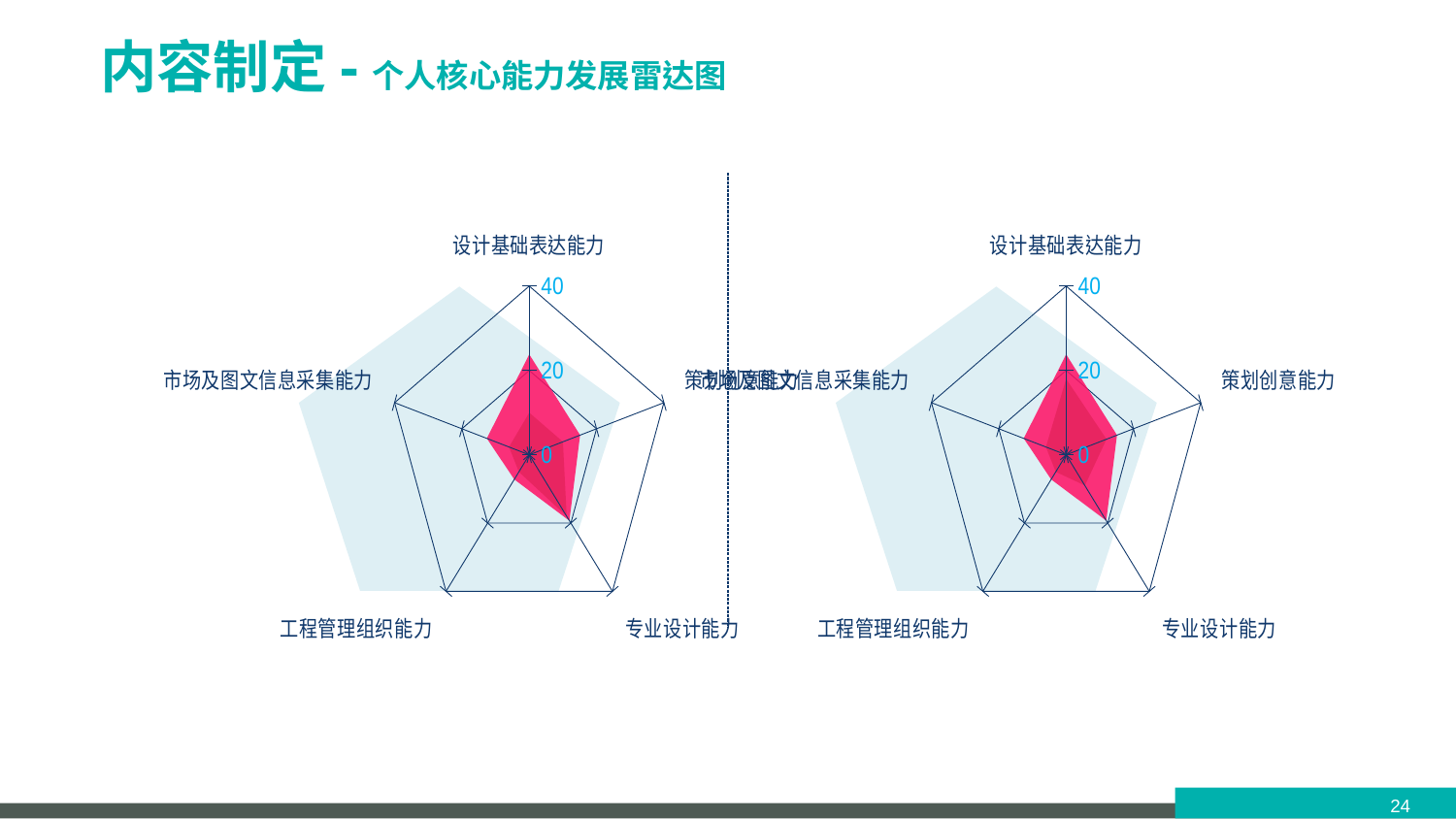
In the left radar chart, how many ability categories are plotted? 5 In the right radar chart, which category label appears at the top of the chart? 设计基础表达能力 In the left radar chart, is the value for 策划创意能力 greater or less than 20? less In the left radar chart, is the value for 设计基础表达能力 greater or less than 40? less In the left radar chart, which category has the lowest value? 工程管理组织能力 What kind of chart is shown on the left side of the slide? radar chart How many charts are shown on the slide? 2 In the left radar chart, which is larger: the value for 设计基础表达能力 or the value for 工程管理组织能力? 设计基础表达能力 What is the maximum value shown on the axis scale of the radar charts? 40 In the left radar chart, which category has the highest value? 设计基础表达能力 In the right radar chart, which category has the highest value? 设计基础表达能力